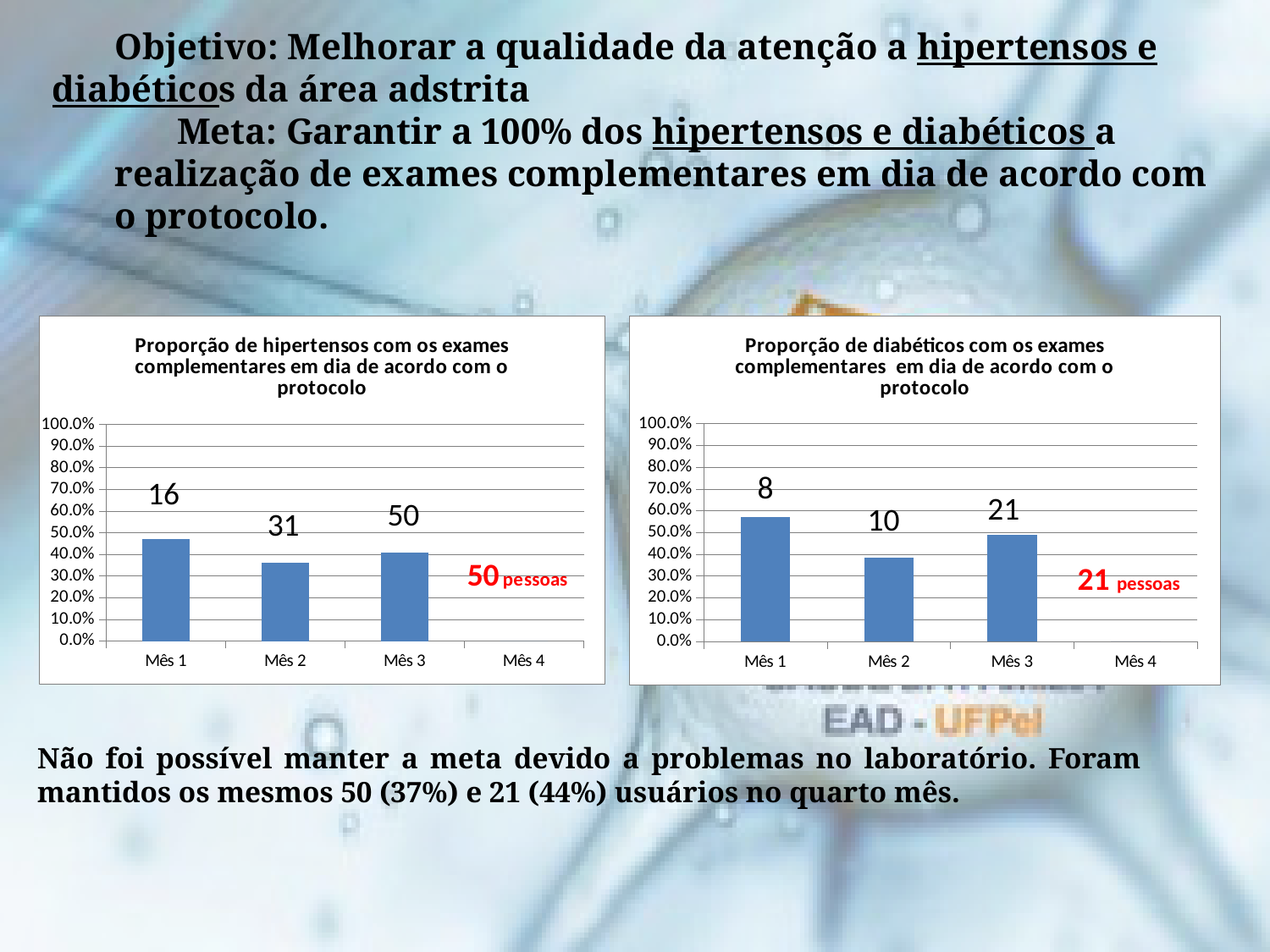
In the left chart (hipertensos), which month has the tallest bar? Mês 1 How many month categories are shown on the x axis of the right chart (diabéticos)? 4 In the left chart (hipertensos), what number is printed above the bar for Mês 1? 16 In the left chart (hipertensos), is the bar for Mês 1 taller or shorter than the bar for Mês 3? taller In the right chart (diabéticos), what number is printed above the bar for Mês 2? 10 In the right chart (diabéticos), what number is printed above the bar for Mês 3? 21 What is the title of the right chart? Proporção de diabéticos com os exames complementares em dia de acordo com o protocolo In the right chart (diabéticos), is the bar for Mês 1 greater or less than 50.0%? greater In the left chart (hipertensos), what number is printed above the bar for Mês 3? 50 In the left chart (hipertensos), is the bar for Mês 2 greater or less than 40.0%? less In the right chart (diabéticos), which month has the shortest bar? Mês 2 What kind of chart is the left chart, 'Proporção de hipertensos com os exames complementares em dia de acordo com o protocolo'? bar chart